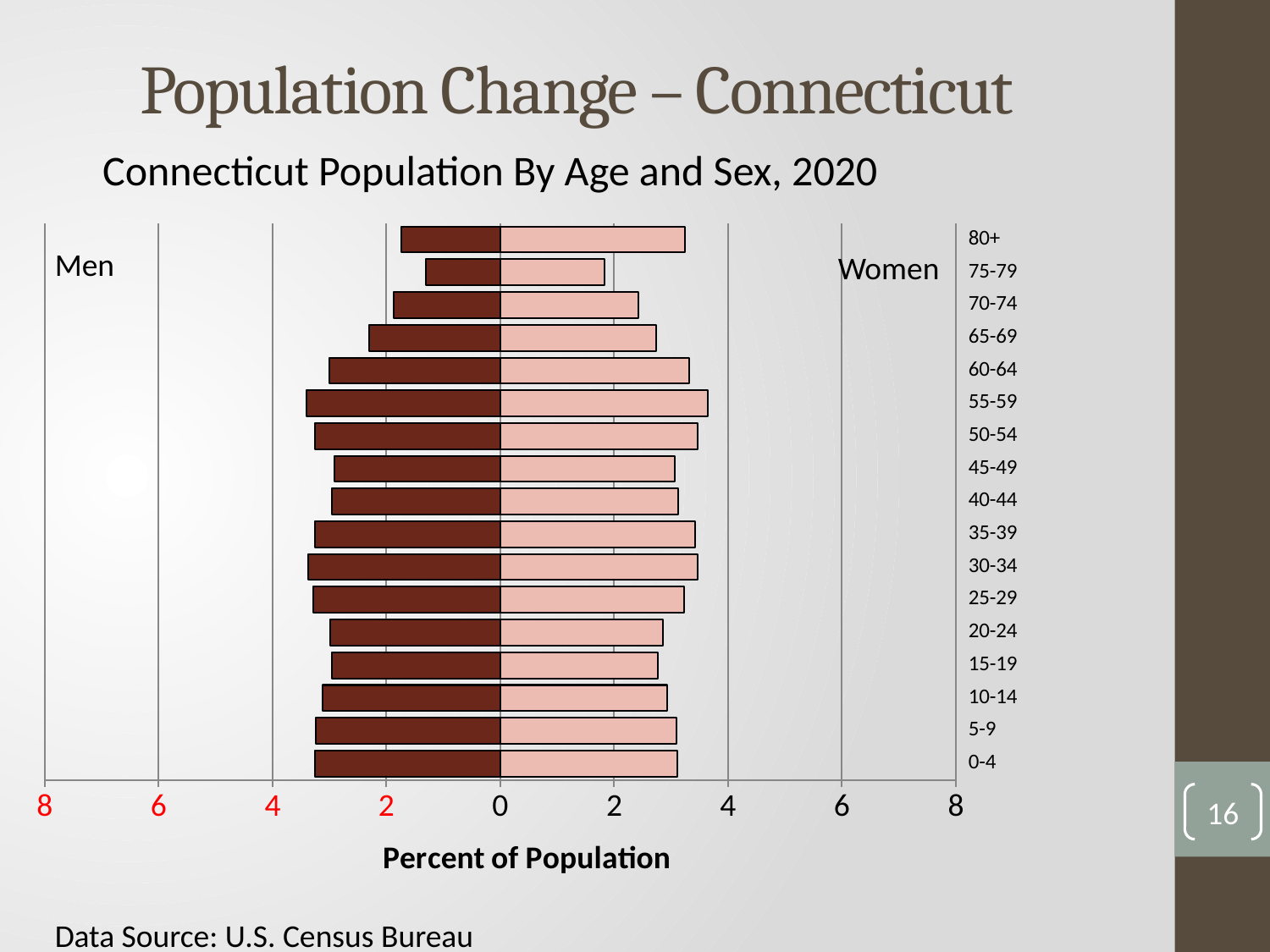
For the 80+ age group, which is larger, the value for Men or for Women? Women What is the title of the x axis? Percent of Population What is the data source cited for the chart? U.S. Census Bureau Is the value for Men aged 55-59 greater or less than 2? greater Is the value for Women aged 80+ greater or less than 2? greater Is the value for Men aged 75-79 greater or less than 2? less How many groups (series) does the chart compare? 2 Which age group has the smallest value for Men? 75-79 What kind of chart is shown on the slide? Bar chart Which age group has the smallest value for Women? 75-79 How many age groups are shown on the chart? 17